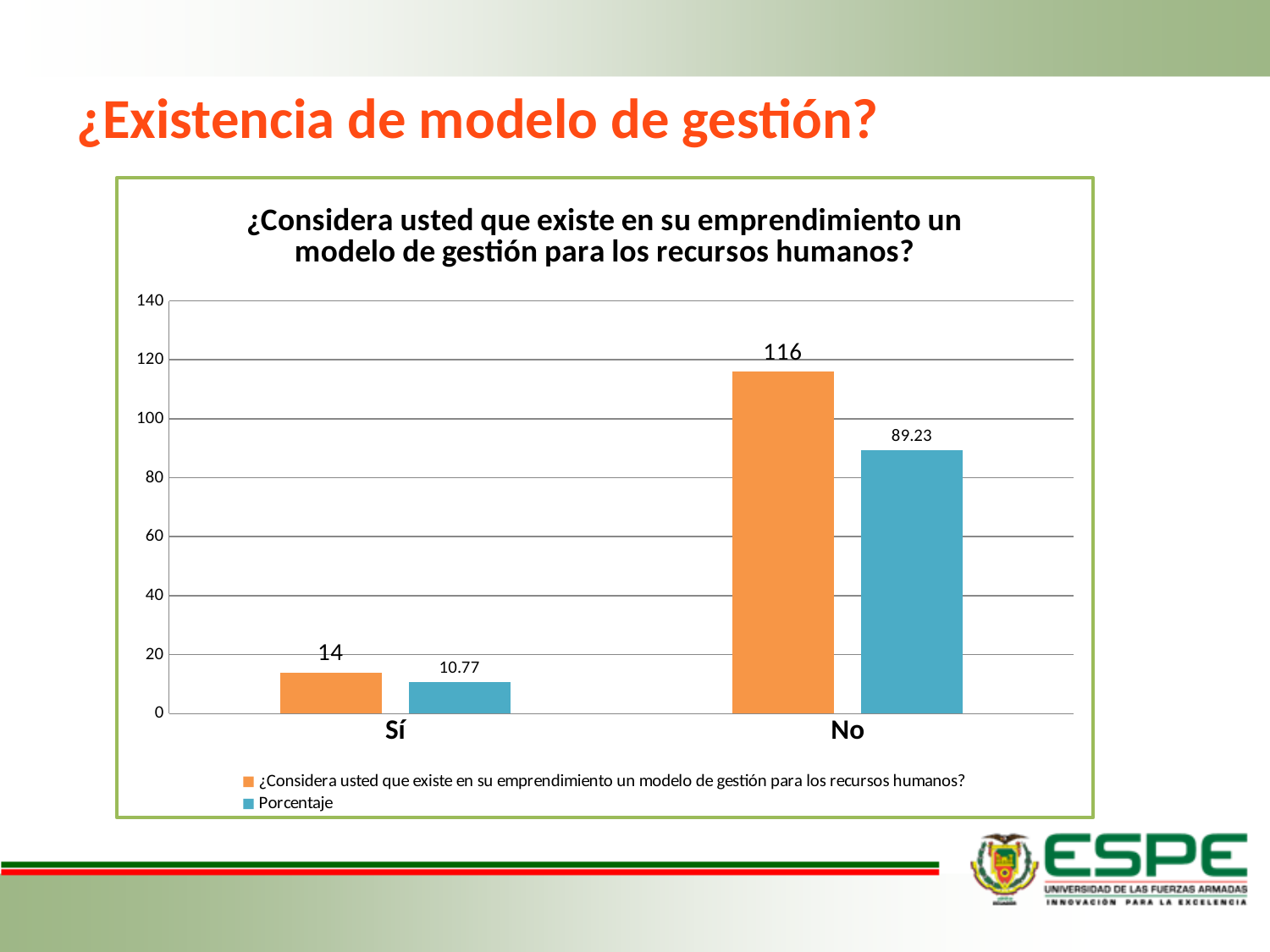
How many categories are shown on the x axis? 2 What is the Porcentaje value for the 'Sí' category? 10.77 What is the count value (orange bar) for the 'Sí' category? 14 Which category has the lowest Porcentaje value? Sí What kind of chart is shown on the slide? Bar chart How many series does the legend list? 2 Which is larger: the Porcentaje for 'No' or the Porcentaje for 'Sí'? No What is the count value (orange bar) for the 'No' category? 116 What is the Porcentaje value for the 'No' category? 89.23 Is the count value for 'No' greater or less than 100? greater What is the difference between the count values for 'No' and 'Sí'? 102 Which category has the highest count value? No